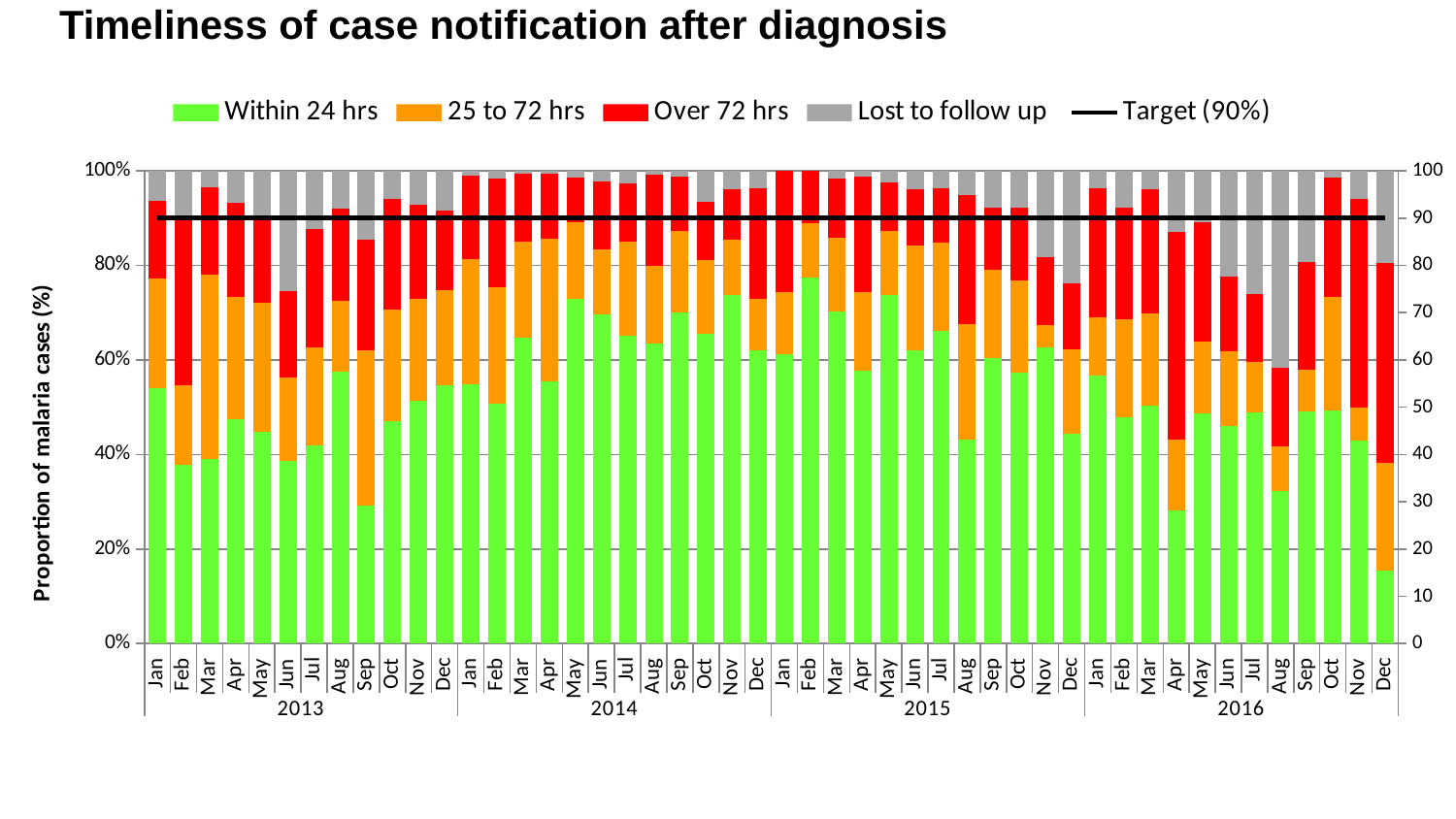
How many series does the legend list? 5 Which is larger, the 'Within 24 hrs' value for Feb 2015 or for Apr 2016? Feb 2015 What type of chart is shown on the slide? Stacked bar chart Is the 'Within 24 hrs' value for Feb 2015 greater or less than 70%? greater Which month has the lowest 'Within 24 hrs' proportion? Dec 2016 What is the label of the left vertical axis? Proportion of malaria cases (%) How many years are covered on the x axis? 4 Is the 'Within 24 hrs' value for Jan 2013 greater or less than 50%? greater Is the 'Within 24 hrs' value for Dec 2016 greater or less than 20%? less How many monthly bars are plotted in total? 48 What is the target percentage shown by the black line? 90%